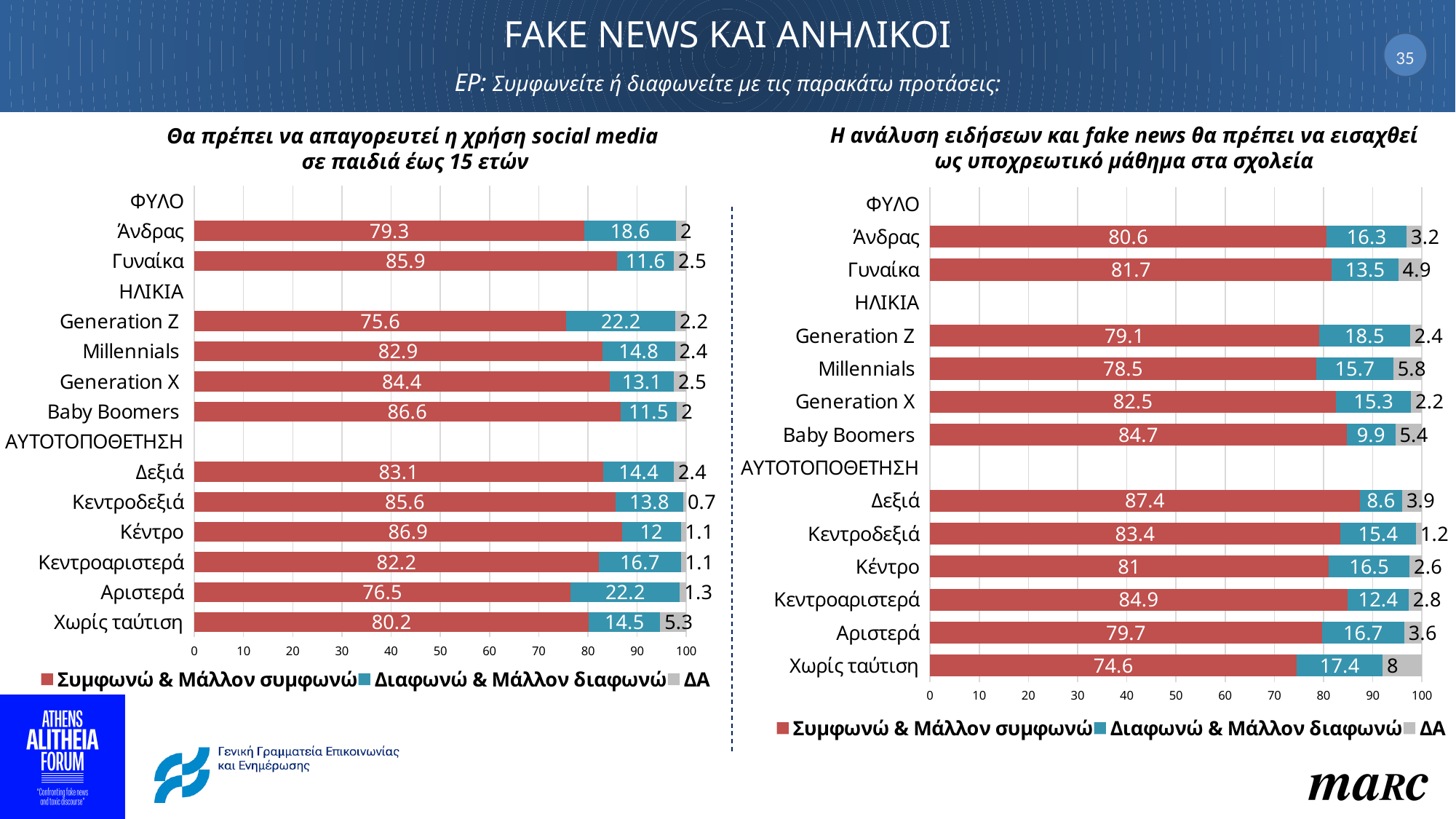
How many categories have bars plotted in the right chart? 12 In the right chart, what is the total of the stacked bar for Δεξιά? 99.9 In the right chart, which category has the highest Συμφωνώ & Μάλλον συμφωνώ value? Δεξιά What type of chart is used on the left side of the slide? Stacked bar chart In the right chart, which has a larger Διαφωνώ & Μάλλον διαφωνώ value: Generation Z or Generation X? Generation Z In the left chart, what is the difference between the Συμφωνώ & Μάλλον συμφωνώ values for Γυναίκα and Άνδρας? 6.6 In the right chart (Η ανάλυση ειδήσεων και fake news θα πρέπει να εισαχθεί ως υποχρεωτικό μάθημα στα σχολεία), what is the value of Διαφωνώ & Μάλλον διαφωνώ for Baby Boomers? 9.9 In the left chart, is the Συμφωνώ & Μάλλον συμφωνώ value for Generation Z greater or less than 80? less How many series does the legend of the left chart list? 3 In the right chart, which category has the lowest Συμφωνώ & Μάλλον συμφωνώ value? Χωρίς ταύτιση In the left chart (Θα πρέπει να απαγορευτεί η χρήση social media σε παιδιά έως 15 ετών), what is the value of Συμφωνώ & Μάλλον συμφωνώ for Γυναίκα? 85.9 In the left chart, which category has the lowest ΔΑ value? Κεντροδεξιά